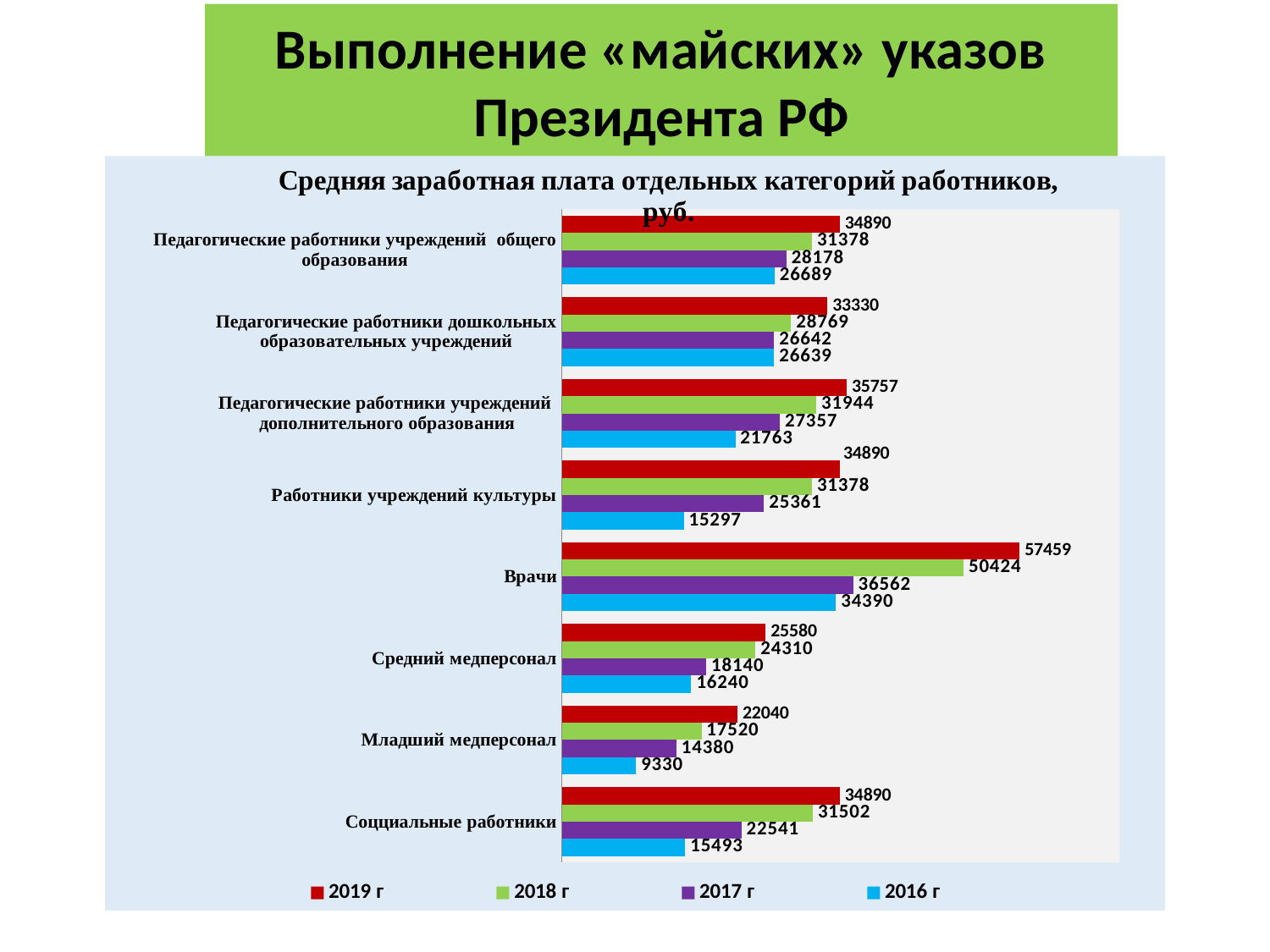
How many categories are shown on the chart? 8 Which category has the lowest value in the 2016 г series? Младший медперсонал Which is larger: the 2018 г value for Средний медперсонал or the 2018 г value for Младший медперсонал? Средний медперсонал What is the value for Врачи in the 2019 г series? 57459 What is the title of the chart? Средняя заработная плата отдельных категорий работников, руб. What is the difference between the 2019 г and 2016 г values for Работники учреждений культуры? 19593 What is the value for Социальные работники in the 2017 г series? 22541 Which category has the highest value in the 2019 г series? Врачи What is the value for Младший медперсонал in the 2016 г series? 9330 What kind of chart is shown on the slide? Bar chart What is the difference between the 2019 г and 2018 г values for Врачи? 7035 How many series does the legend list? 4